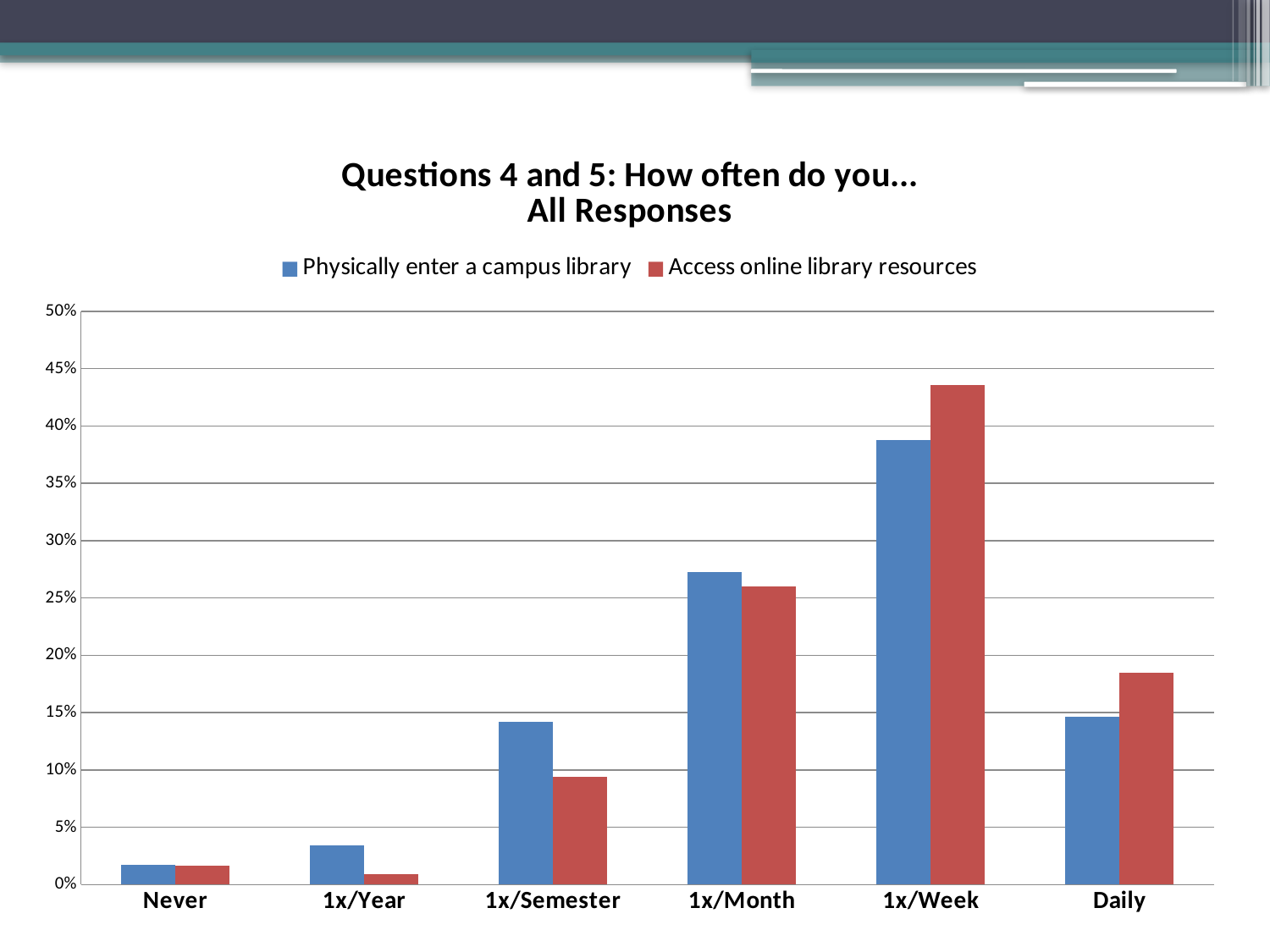
Which category has the lowest value for 'Access online library resources'? 1x/Year What kind of chart is shown on the slide? bar chart How many categories are shown on the x axis? 6 Is the value for 'Access online library resources' at 1x/Week greater or less than 40%? greater Which category has the highest value for 'Physically enter a campus library'? 1x/Week Is the value for 'Physically enter a campus library' at 1x/Month greater or less than 25%? greater For the Daily category, which series has the larger value: 'Physically enter a campus library' or 'Access online library resources'? Access online library resources Which category has the lowest value for 'Physically enter a campus library'? Never How many series does the legend list? 2 For the 1x/Semester category, which series has the larger value: 'Physically enter a campus library' or 'Access online library resources'? Physically enter a campus library Is the value for 'Access online library resources' at 1x/Semester greater or less than 10%? less Which category has the highest value for 'Access online library resources'? 1x/Week